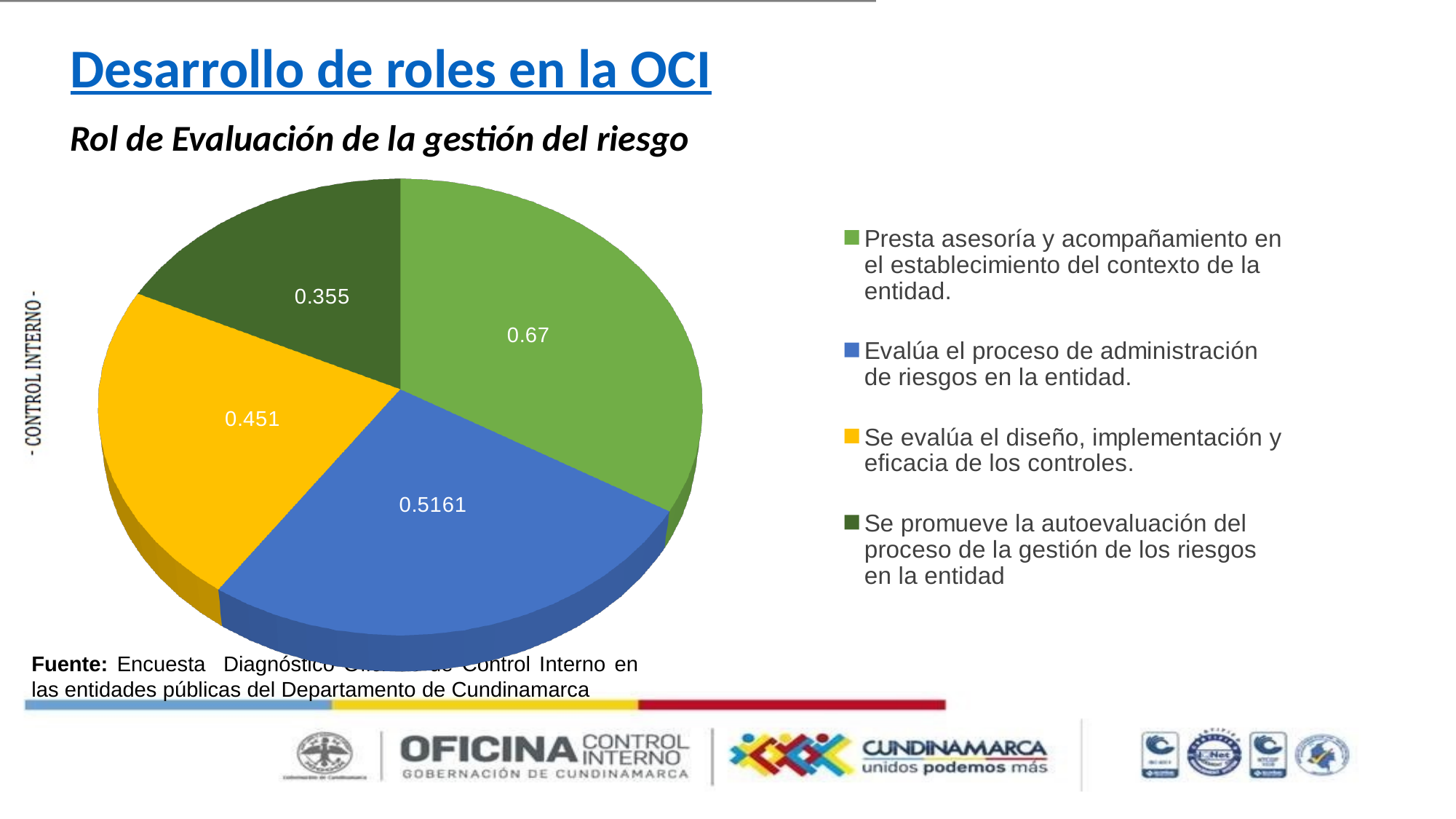
What is the value for "Se promueve la autoevaluación del proceso de la gestión de los riesgos en la entidad"? 0.355 What colour is the slice for "Se evalúa el diseño, implementación y eficacia de los controles."? Yellow How many slices does the pie chart have? 4 What is the value for "Se evalúa el diseño, implementación y eficacia de los controles."? 0.451 What is the difference between the largest value (0.67) and the smallest value (0.355) in the pie chart? 0.315 What is the value for "Presta asesoría y acompañamiento en el establecimiento del contexto de la entidad."? 0.67 What kind of chart is shown on the slide? Pie chart Which category has the highest value in the pie chart? Presta asesoría y acompañamiento en el establecimiento del contexto de la entidad. Which is larger: the value for "Evalúa el proceso de administración de riesgos en la entidad." or the value for "Se evalúa el diseño, implementación y eficacia de los controles."? Evalúa el proceso de administración de riesgos en la entidad. Which category has the lowest value in the pie chart? Se promueve la autoevaluación del proceso de la gestión de los riesgos en la entidad What is the value for "Evalúa el proceso de administración de riesgos en la entidad."? 0.5161 What is the difference between the values for "Evalúa el proceso de administración de riesgos en la entidad." and "Se evalúa el diseño, implementación y eficacia de los controles."? 0.0651